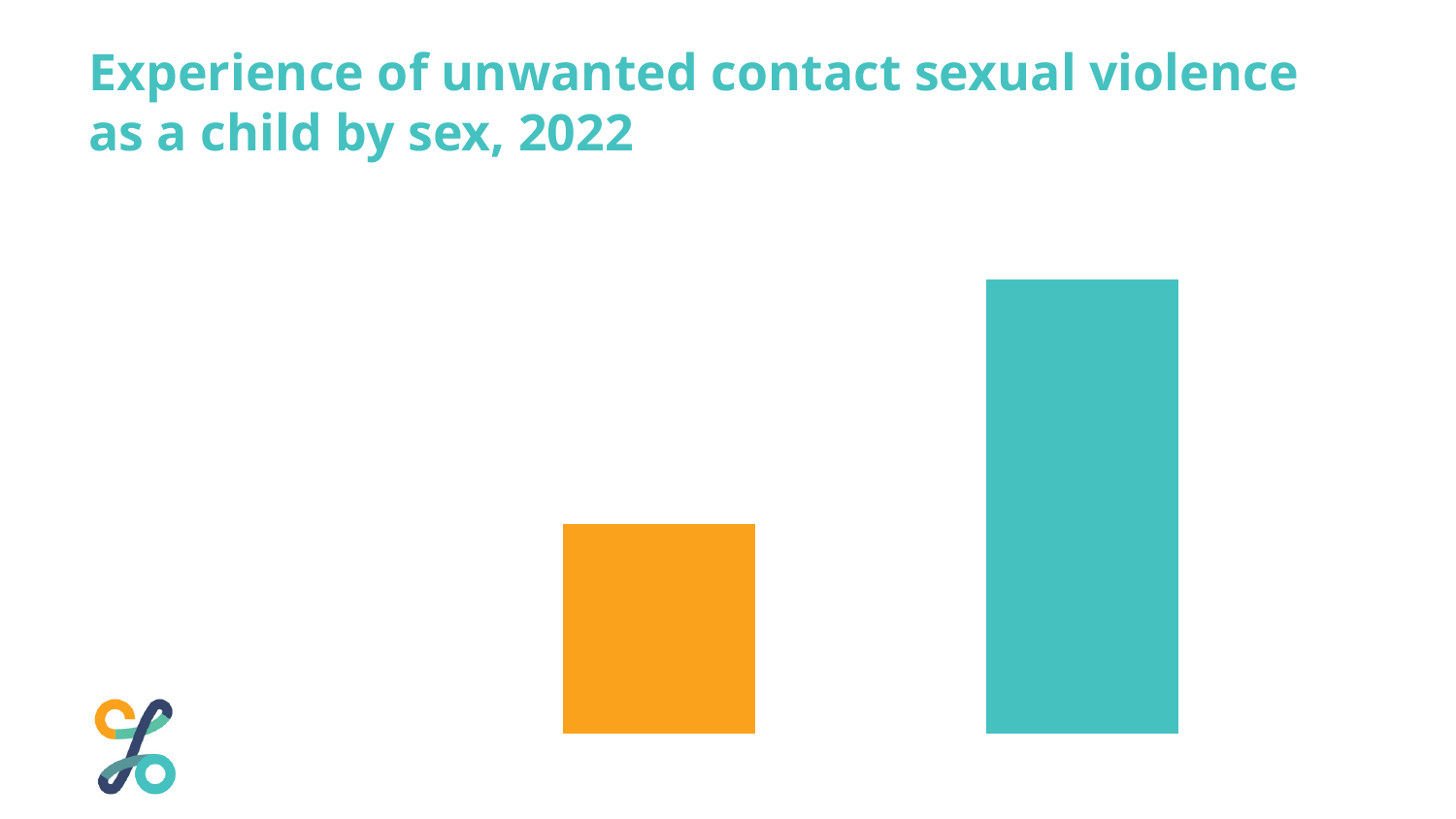
What is the title of the slide's chart? Experience of unwanted contact sexual violence as a child by sex, 2022 Which bar is taller, the orange bar on the left or the teal bar on the right? the teal bar on the right How many bars does the chart show? 2 What colour is the left bar in the chart? orange What kind of chart is shown on the slide? bar chart Which bar is the tallest in the chart? the teal bar on the right Which bar is the shortest in the chart? the orange bar on the left